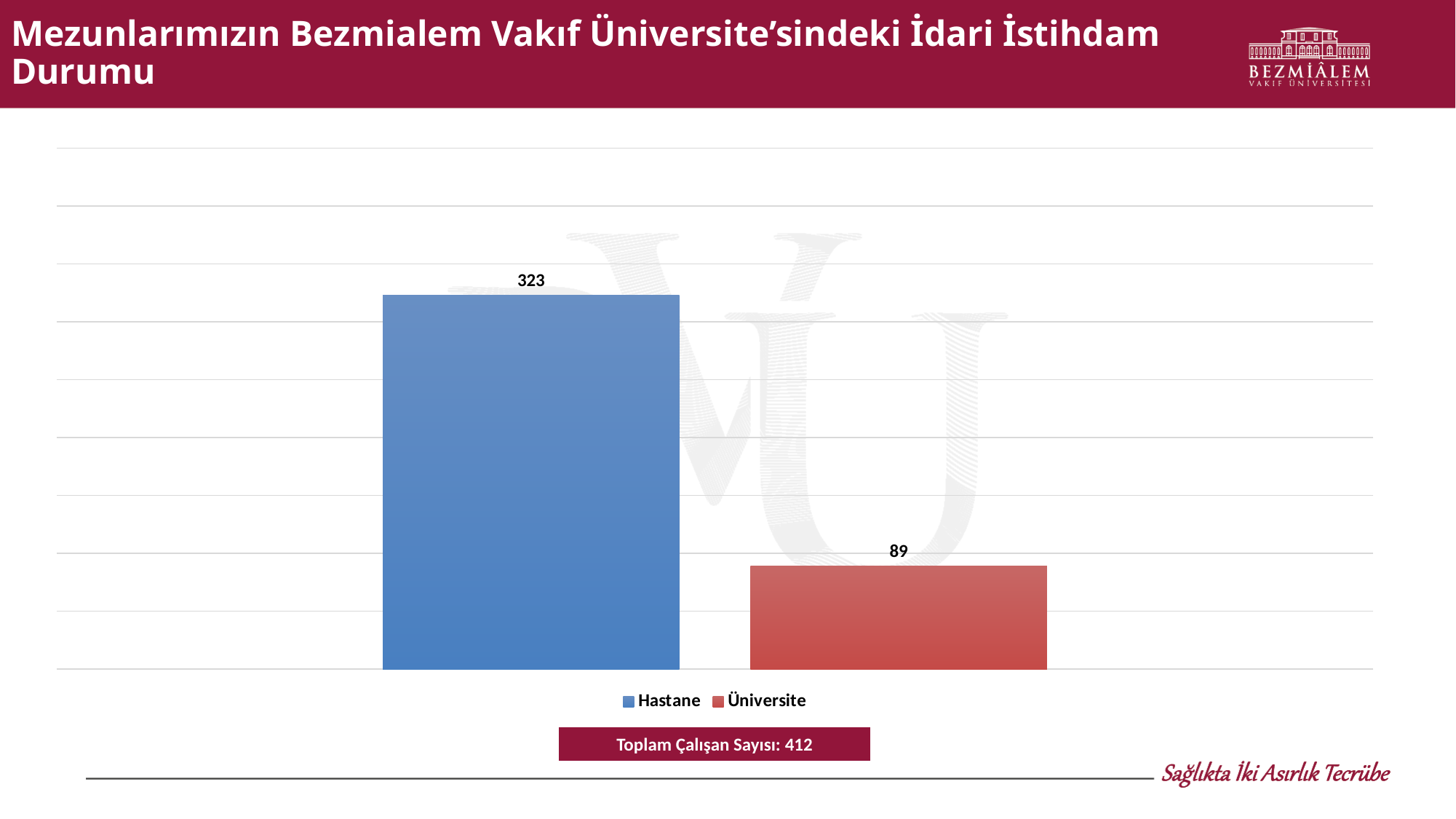
What is the difference between the Hastane and Üniversite values? 234 What kind of chart is shown on the slide? bar chart What is the value for Hastane? 323 What colour is the Hastane bar? blue What total number of employees (Toplam Çalışan Sayısı) is stated below the chart? 412 How many bars are plotted in the chart? 2 What is the value for Üniversite? 89 Which category has the lowest value? Üniversite What is the total of the two plotted values? 412 Which is larger, the value for Hastane or the value for Üniversite? Hastane Which category has the highest value? Hastane How many entries does the legend list? 2